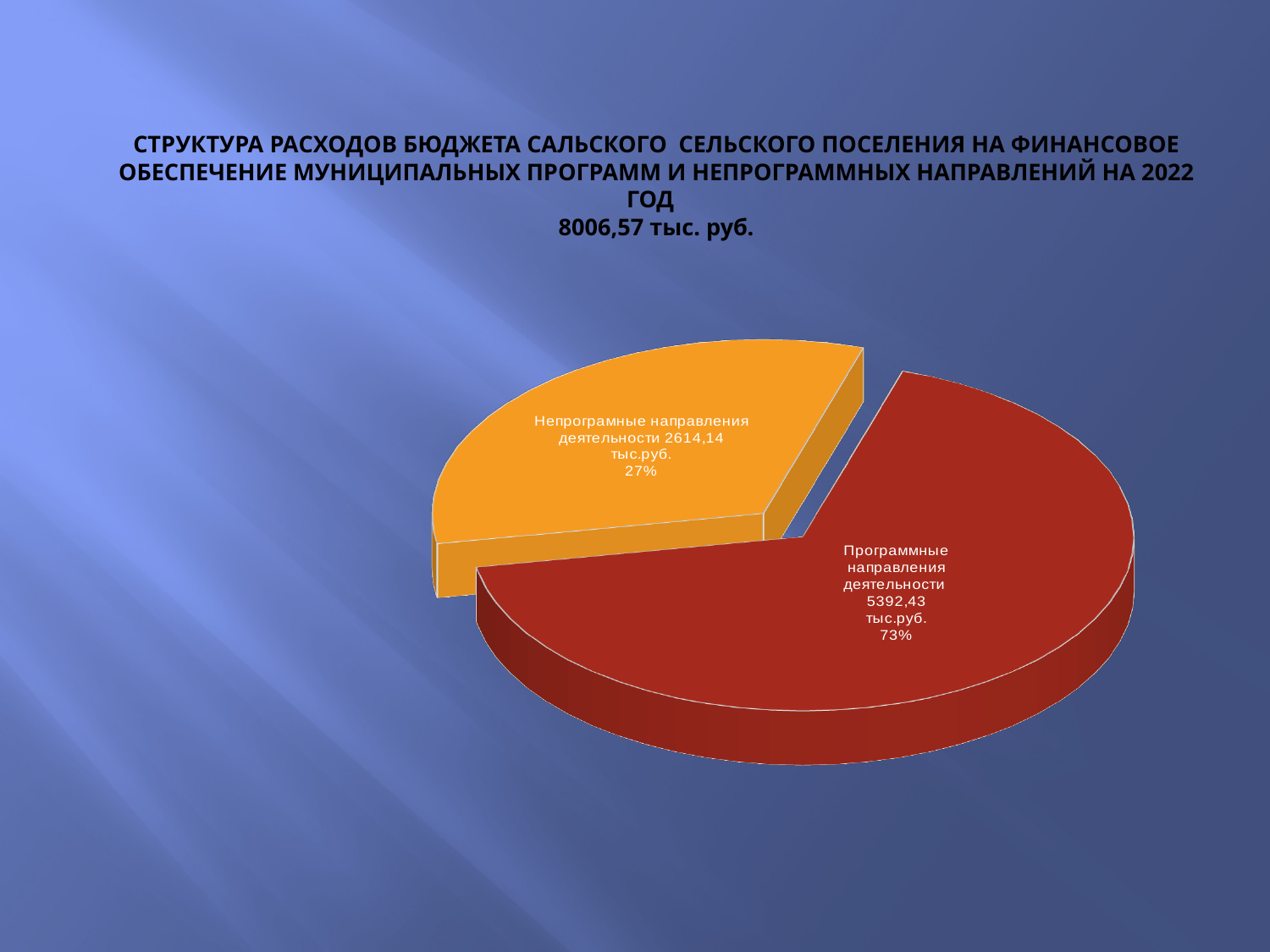
What kind of chart is shown on the slide? Pie chart What total amount is stated in the chart title? 8006,57 тыс. руб. What is the value shown for Программные направления деятельности? 5392,43 тыс.руб. Which slice of the pie chart is the largest? Программные направления деятельности How many slices does the pie chart have? 2 What is the difference in value between Программные направления деятельности and Непрограмные направления деятельности? 2778,29 тыс.руб. Which is larger: Программные направления деятельности or Непрограмные направления деятельности? Программные направления деятельности What share of the pie does Непрограмные направления деятельности take? 27% What colour is the slice for Непрограмные направления деятельности? Orange What share of the pie does Программные направления деятельности take? 73% What is the value shown for Непрограмные направления деятельности? 2614,14 тыс.руб. Which slice of the pie chart is the smallest? Непрограмные направления деятельности